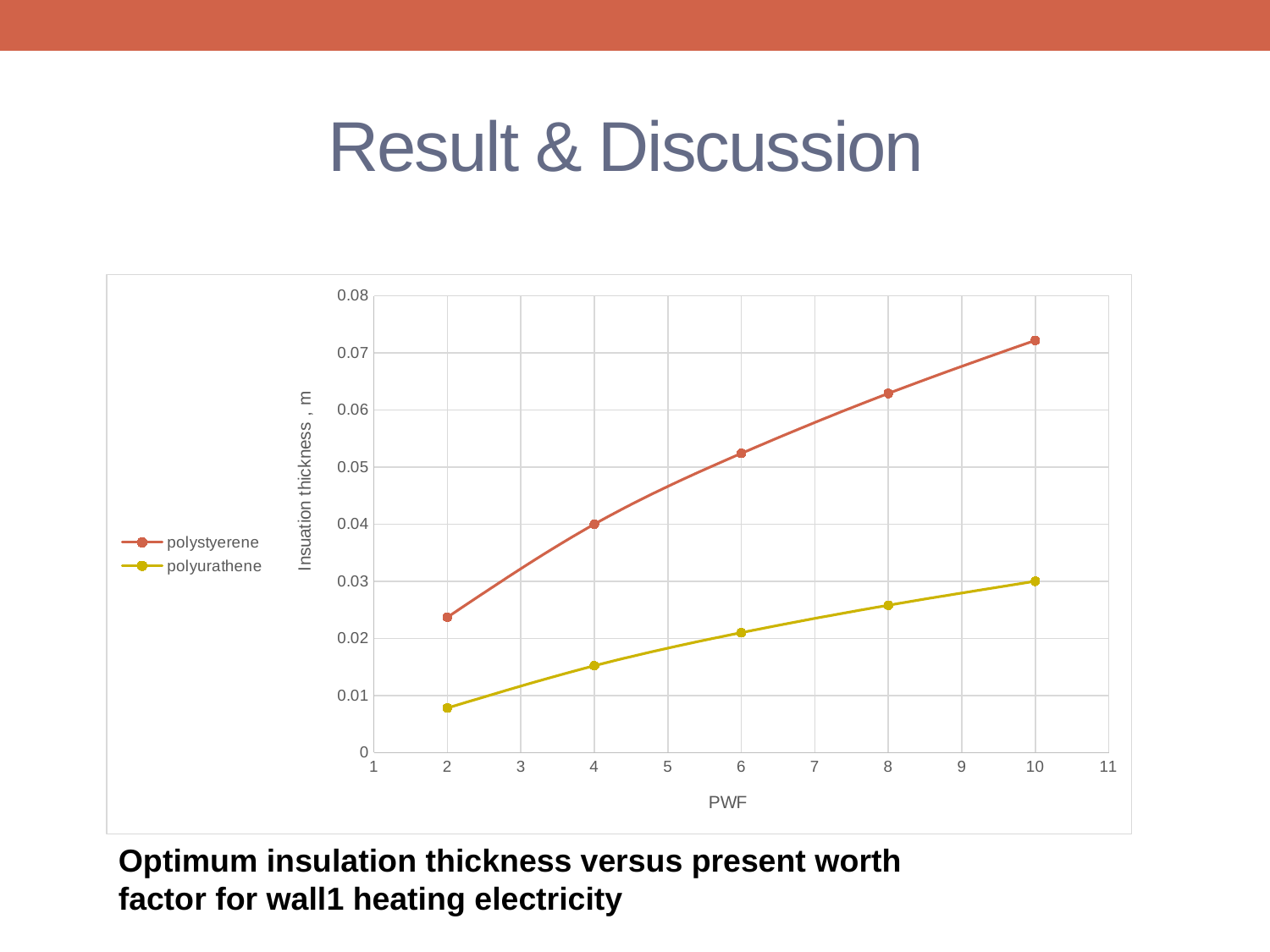
Is the polyurathene value at PWF 8 greater or less than 0.03? less How many data points are plotted for the polystyerene series? 5 What kind of chart is shown on the slide? line chart Is the polystyerene value at PWF 2 greater or less than 0.02? greater At which PWF value is the polyurathene insulation thickness lowest? 2 Is the polystyerene value at PWF 10 greater or less than 0.07? greater What is the label of the x axis? PWF At which PWF value is the polystyerene insulation thickness highest? 10 Do the polyurathene values rise or fall as PWF increases? rise How many series does the legend list? 2 At PWF 6, which series has the larger insulation thickness, polystyerene or polyurathene? polystyerene